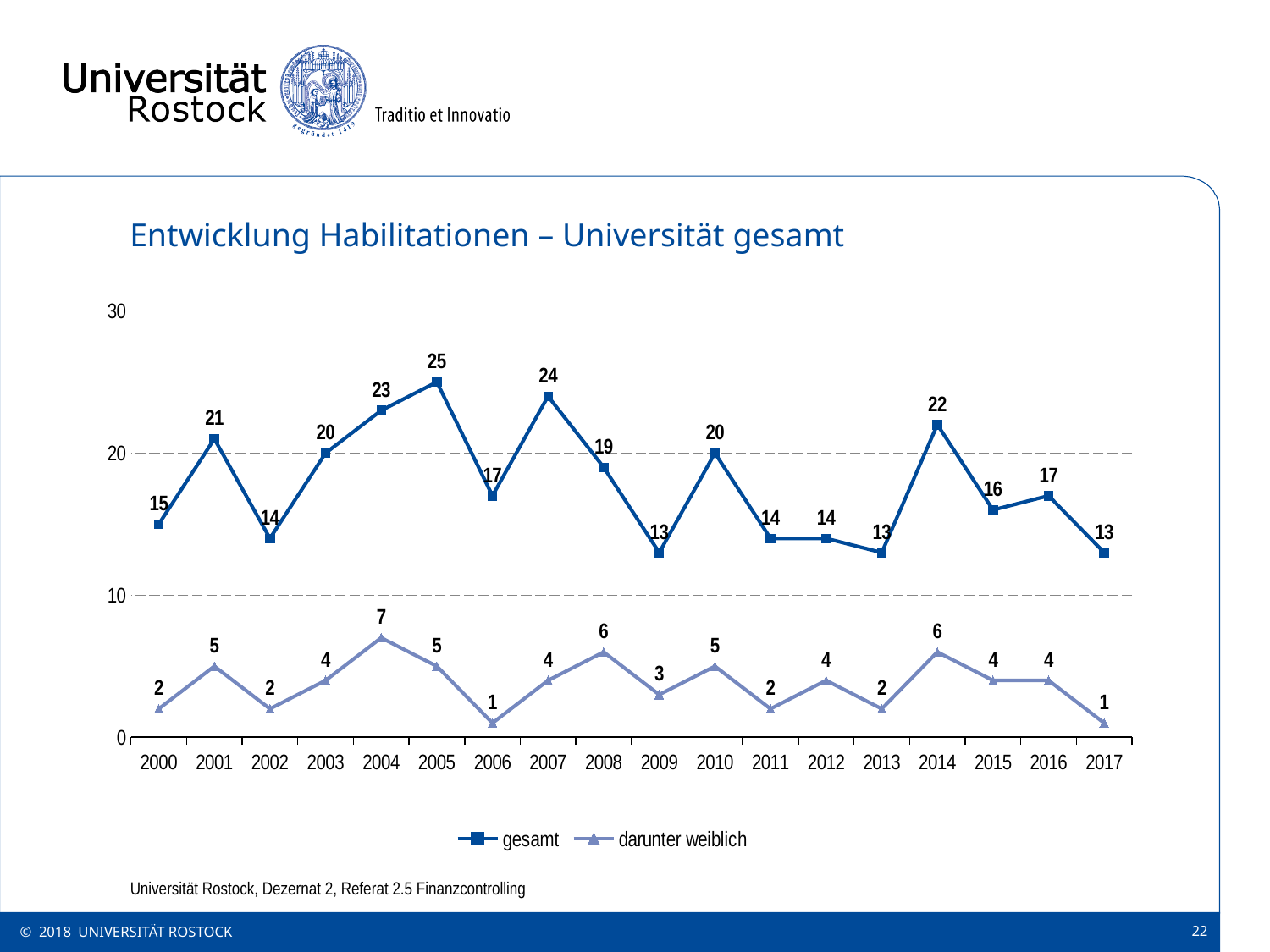
What is the title of the chart? Entwicklung Habilitationen – Universität gesamt Which is larger: the 'gesamt' value in 2014 or the 'gesamt' value in 2016? 2014 Is the 'gesamt' value for 2004 greater or less than 20? greater What is the lowest value of the 'darunter weiblich' series? 1 Does the 'gesamt' series rise or fall from 2014 to 2015? fall How many years are shown on the x axis? 18 In which year does the 'gesamt' series reach its highest value? 2005 What is the value of the 'darunter weiblich' series in 2004? 7 How many series does the legend list? 2 What is the value of the 'gesamt' series in 2005? 25 What kind of chart is shown on the slide? line chart What is the difference between the 'gesamt' value in 2007 and the 'gesamt' value in 2009? 11